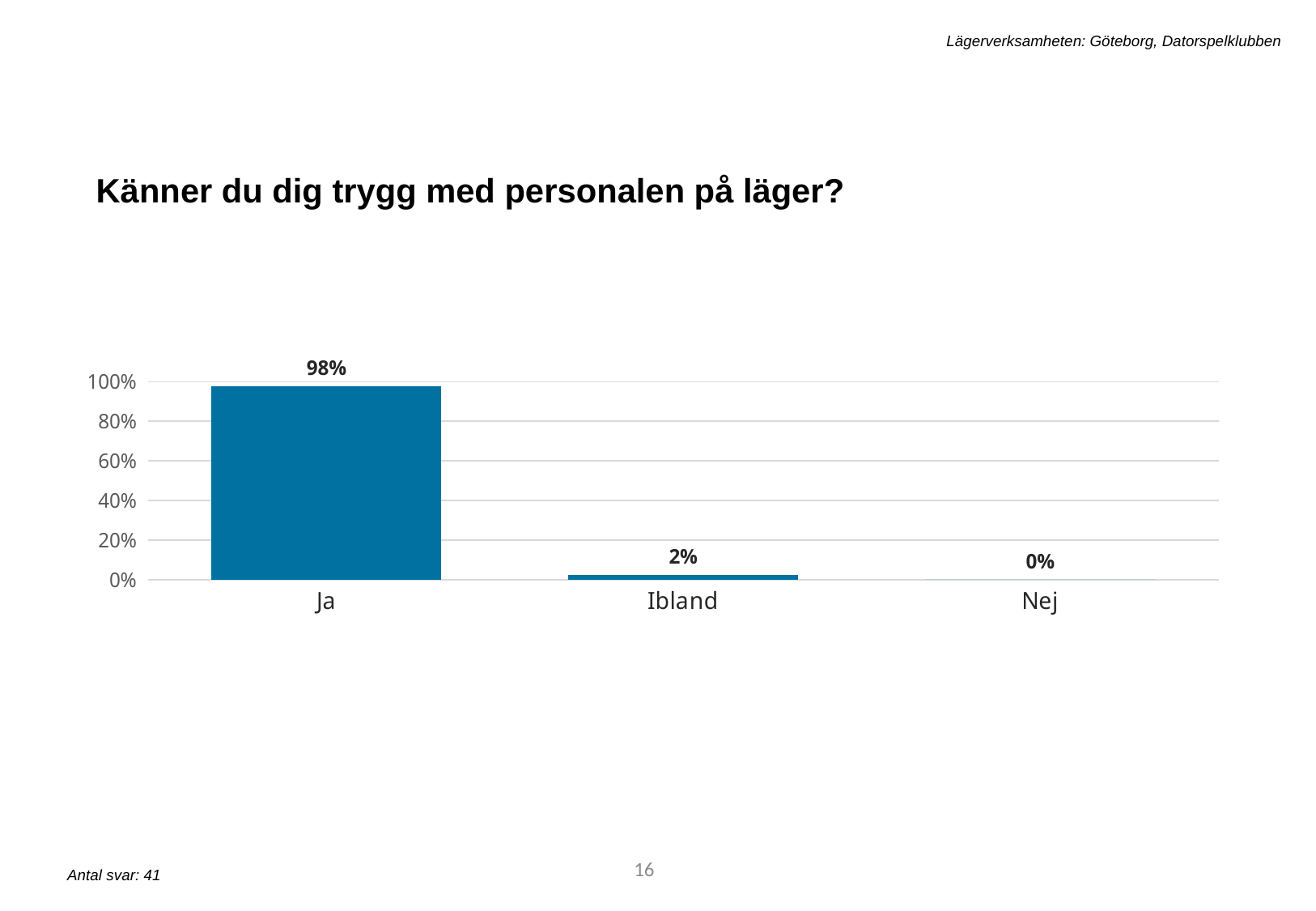
What is the value for Nej? 0% What is the difference between the values for Ja and Ibland? 96% How many categories are shown on the x axis? 3 What is the title of the chart? Känner du dig trygg med personalen på läger? Do the values rise or fall from left to right along the x axis? fall What kind of chart is shown on the slide? bar chart Which category has the highest value? Ja Is the value for Ja greater or less than 80%? greater What is the value for Ibland? 2% Which is larger, the value for Ibland or the value for Nej? Ibland What is the value for Ja? 98% Which category has the lowest value? Nej